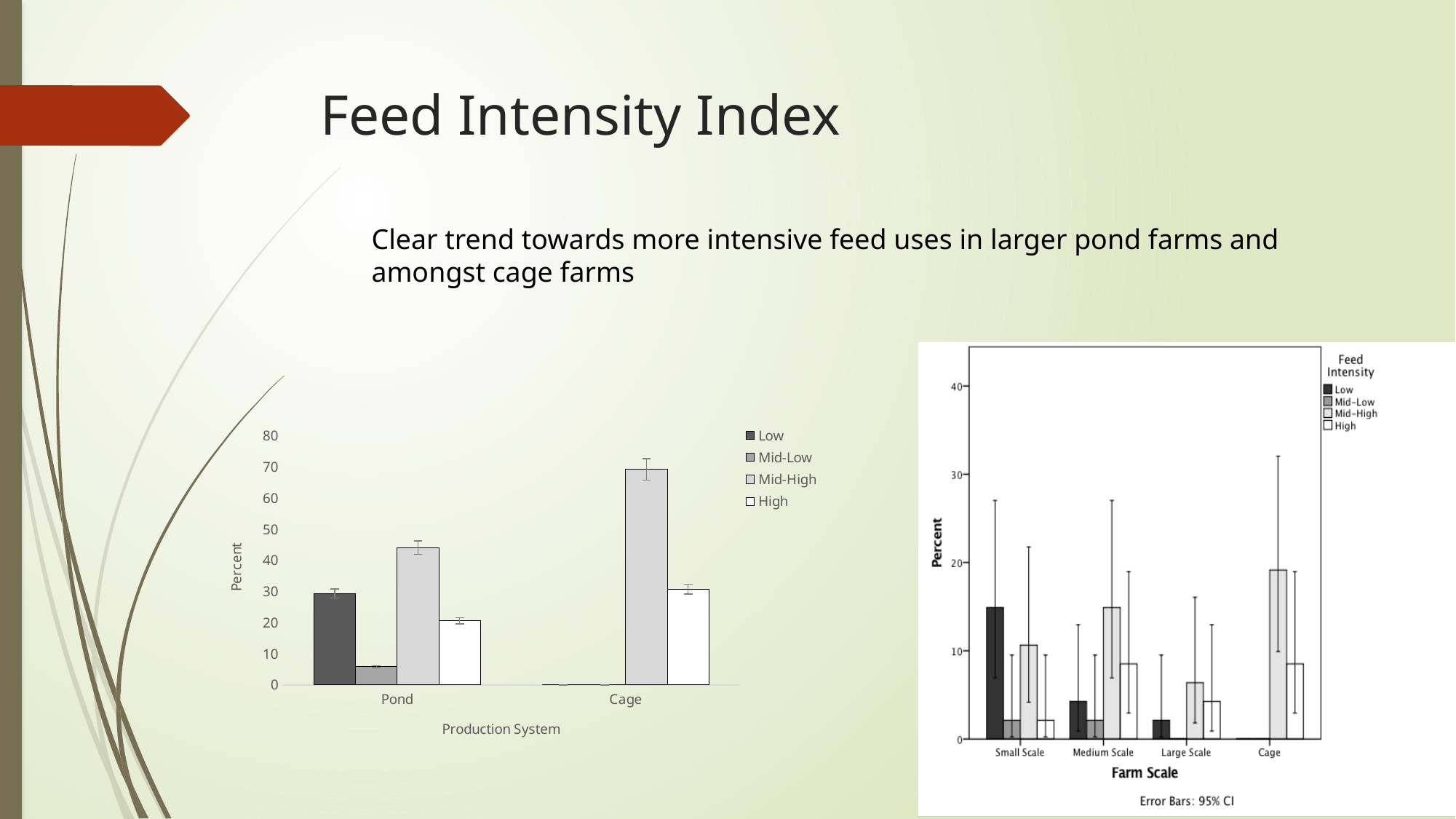
In the left chart (Production System), is the Mid-High value for Cage greater or less than 60? greater In the right chart (Farm Scale), what confidence level do the error bars represent according to the note below the chart? 95% CI In the left chart (Production System), how many production systems are shown on the x axis? 2 In the right chart (Farm Scale), which farm scale has the highest Mid-High bar? Cage In the right chart (Farm Scale), how many farm scale categories are shown on the x axis? 4 In the left chart (Production System), is the High value larger for Pond or for Cage? Cage In the left chart (Production System), how many series does the legend list? 4 What kind of chart is the left chart with the x axis labelled Production System? bar chart In the left chart (Production System), which feed intensity series has the lowest bar for Pond? Mid-Low In the left chart (Production System), which feed intensity series has the highest bar for Pond? Mid-High In the right chart (Farm Scale), is the Low value for Small Scale greater or less than 10? greater In the left chart (Production System), is the Low value for Pond greater or less than 20? greater